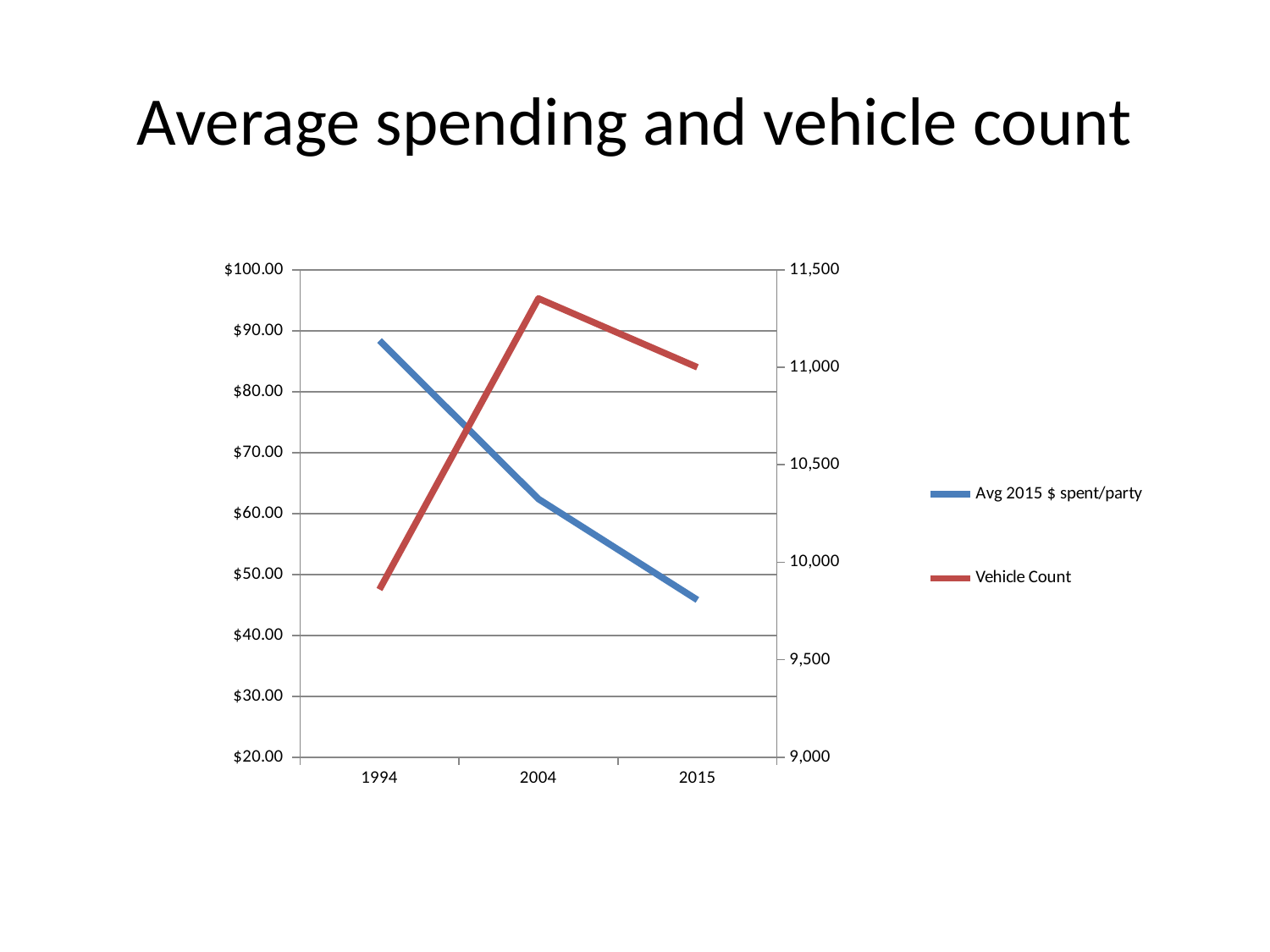
How many years are plotted along the x axis? 3 In which year is the Avg 2015 $ spent/party value highest? 1994 In which year is the Vehicle Count lowest? 1994 What is the title of the chart? Average spending and vehicle count In which year is the Vehicle Count highest? 2004 How many series does the legend list? 2 What kind of chart is shown on the slide? line chart In which year is the Avg 2015 $ spent/party value lowest? 2015 Is the Avg 2015 $ spent/party value for 1994 greater or less than $80.00? greater Is the Avg 2015 $ spent/party value for 2015 greater or less than $50.00? less Is the Vehicle Count for 1994 greater or less than 10,000? less Does the Avg 2015 $ spent/party line rise or fall from 1994 to 2015? fall